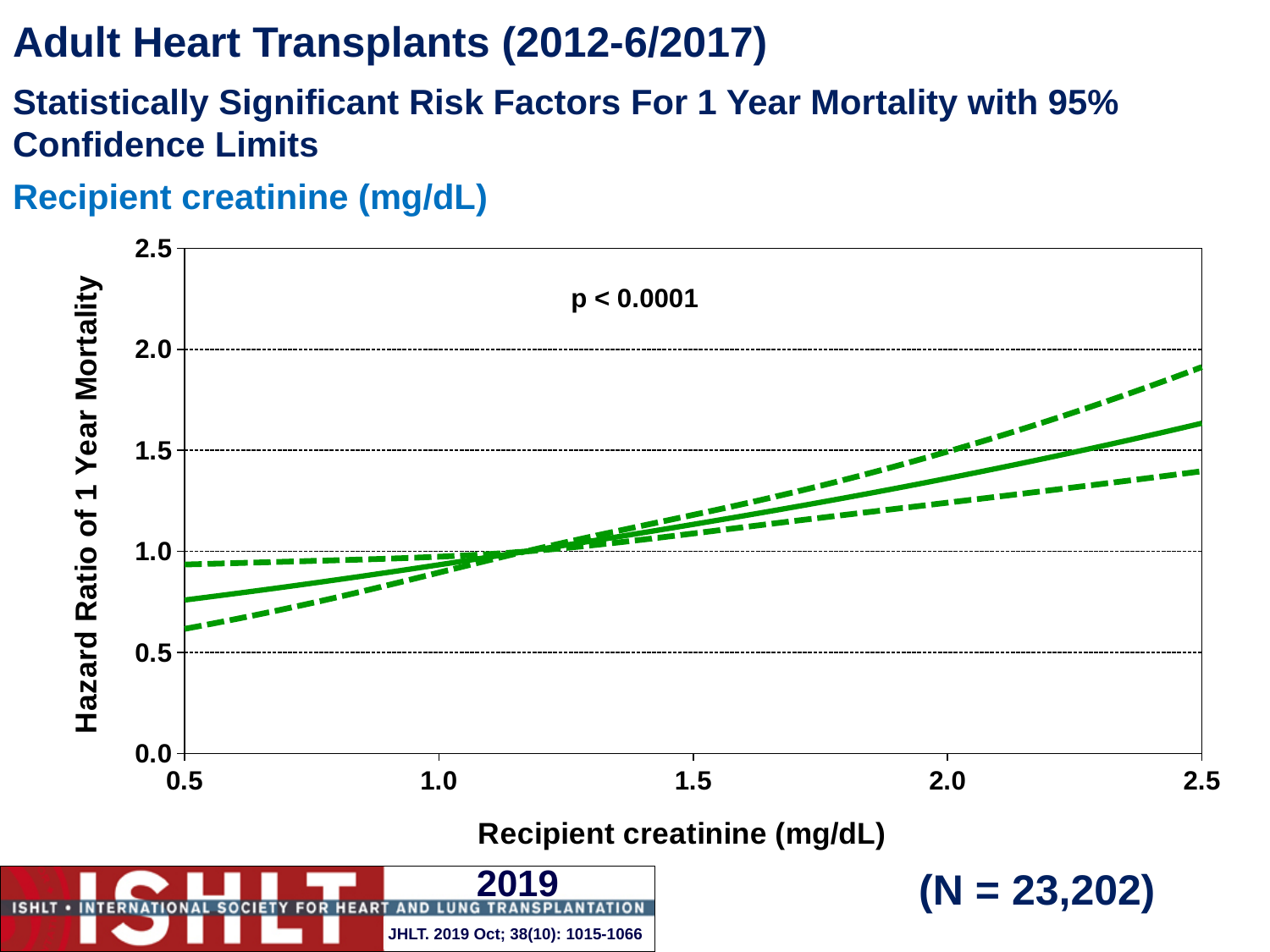
What p-value is printed on the chart? p < 0.0001 Does the hazard ratio of 1 year mortality rise or fall as recipient creatinine increases from 0.5 to 2.5 mg/dL? rise How many lines are plotted on the chart? 3 Is the hazard ratio (solid line) at a recipient creatinine of 2.5 mg/dL greater or less than 1.5? greater Is the lower 95% confidence limit at a recipient creatinine of 0.5 mg/dL greater or less than 0.5? greater Is the lower 95% confidence limit at a recipient creatinine of 2.5 mg/dL greater or less than 1.5? less What is the label of the y axis? Hazard Ratio of 1 Year Mortality What kind of chart is shown on the slide? line chart